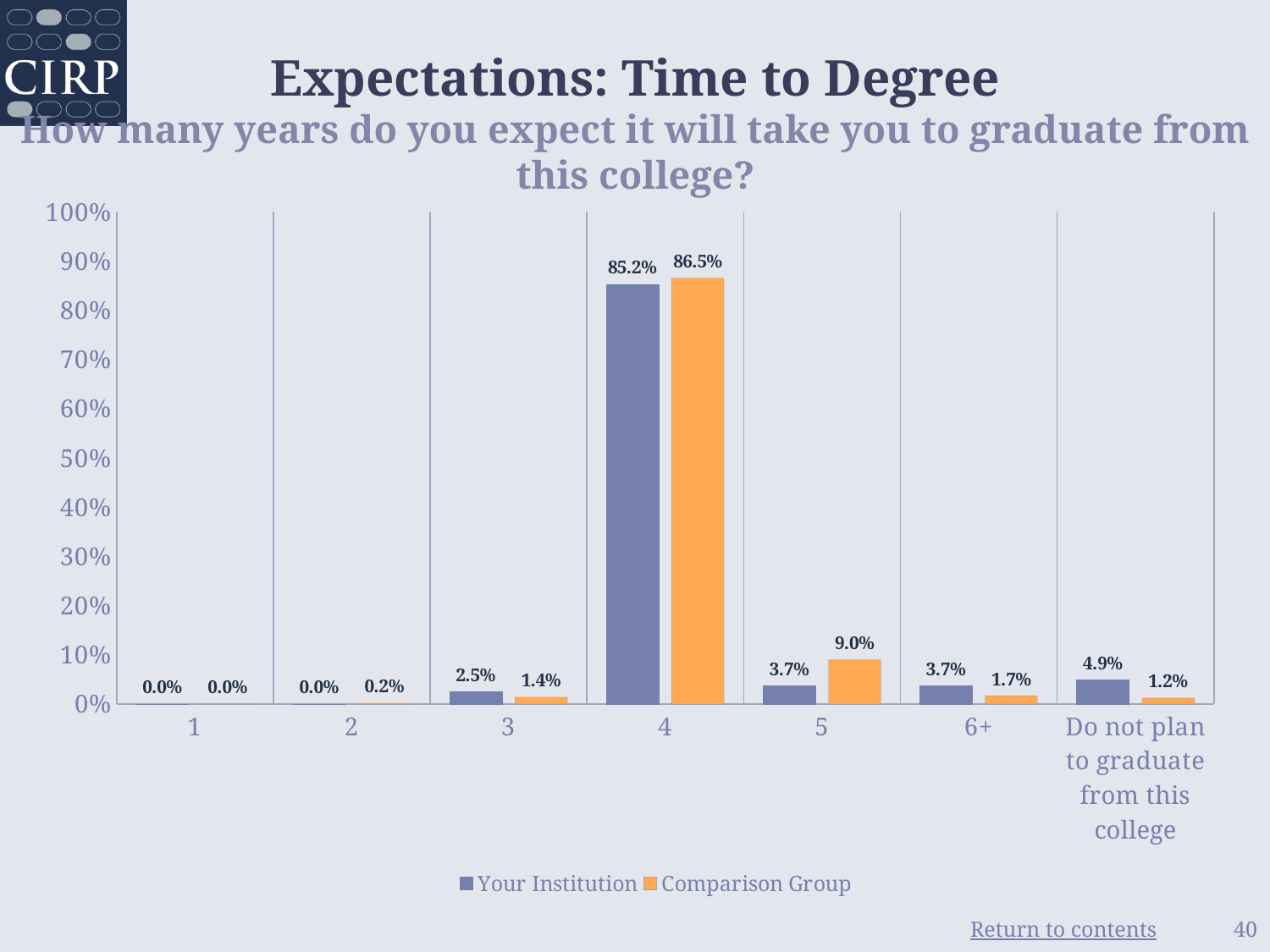
What is the difference between the Your Institution and Comparison Group values for the category 3? 1.1% What is the value for Your Institution for the category 4? 85.2% What is the value for Comparison Group for the category 5? 9.0% What kind of chart is shown on the slide? bar chart How many categories are shown on the x axis? 7 What is the difference between the Comparison Group and Your Institution values for the category 4? 1.3% What is the value for Your Institution for 'Do not plan to graduate from this college'? 4.9% Is the value for Your Institution for the category 4 greater or less than 80%? greater What colour represents the Comparison Group series? orange How many series does the legend list? 2 Which category has the highest value for Comparison Group? 4 For the category 6+, which series has the larger value, Your Institution or Comparison Group? Your Institution